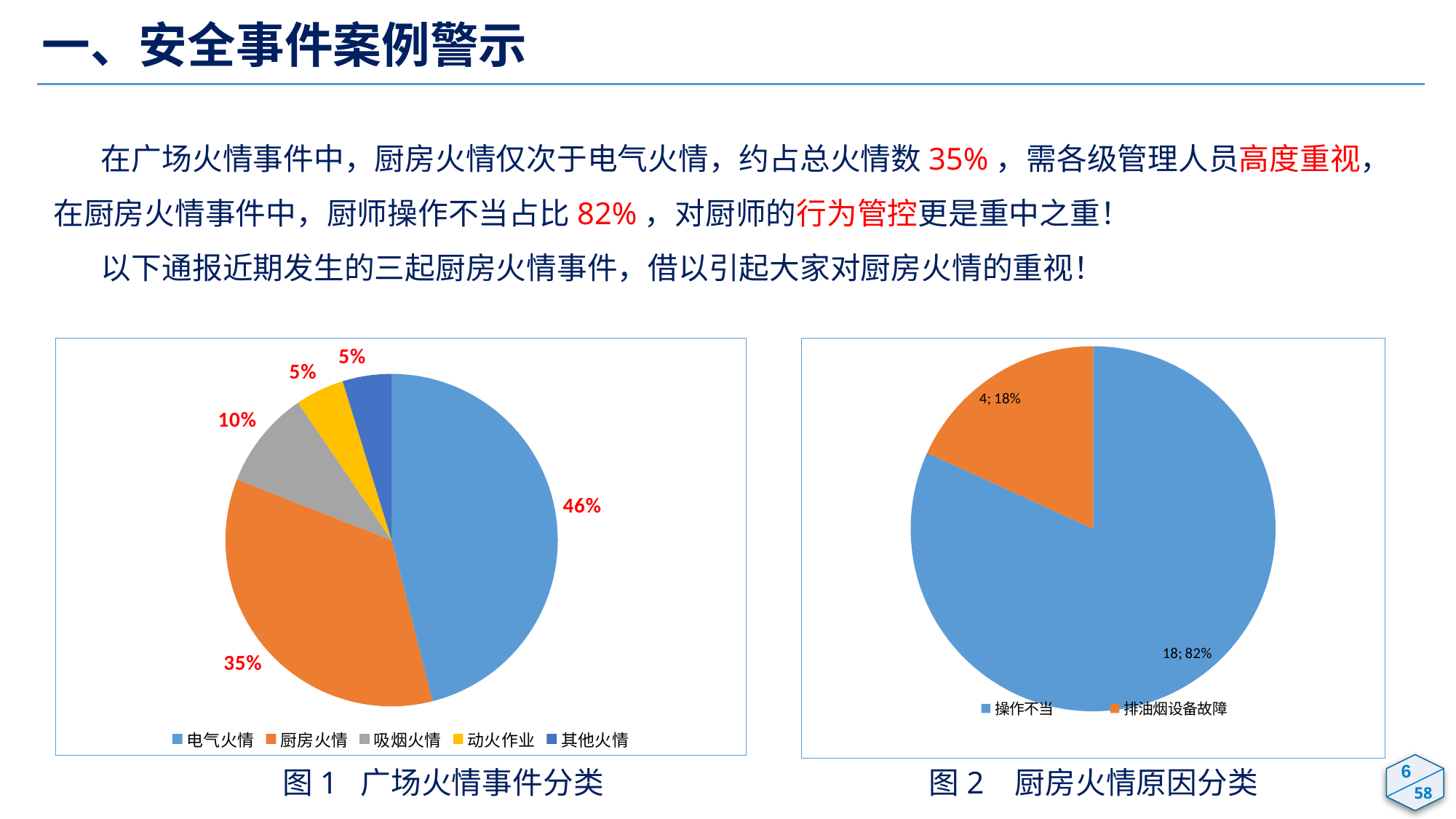
In the left chart (图1 广场火情事件分类), what share of the pie is 吸烟火情? 10% In the left chart (图1 广场火情事件分类), which is larger, 吸烟火情 or 动火作业? 吸烟火情 In the left chart (图1 广场火情事件分类), what share of the pie is 电气火情? 46% In the left chart (图1 广场火情事件分类), what is the difference in percentage points between 电气火情 and 厨房火情? 11 In the right chart (图2 厨房火情原因分类), what share of the pie is 排油烟设备故障? 18% In the right chart (图2 厨房火情原因分类), which category has the smallest slice? 排油烟设备故障 In the right chart (图2 厨房火情原因分类), what is the value shown for 操作不当? 18; 82% In the left chart (图1 广场火情事件分类), which category has the largest slice? 电气火情 In the left chart (图1 广场火情事件分类), how many categories does the legend list? 5 What kind of chart is 图2 厨房火情原因分类? Pie chart In the right chart (图2 厨房火情原因分类), what is the total count across both categories? 22